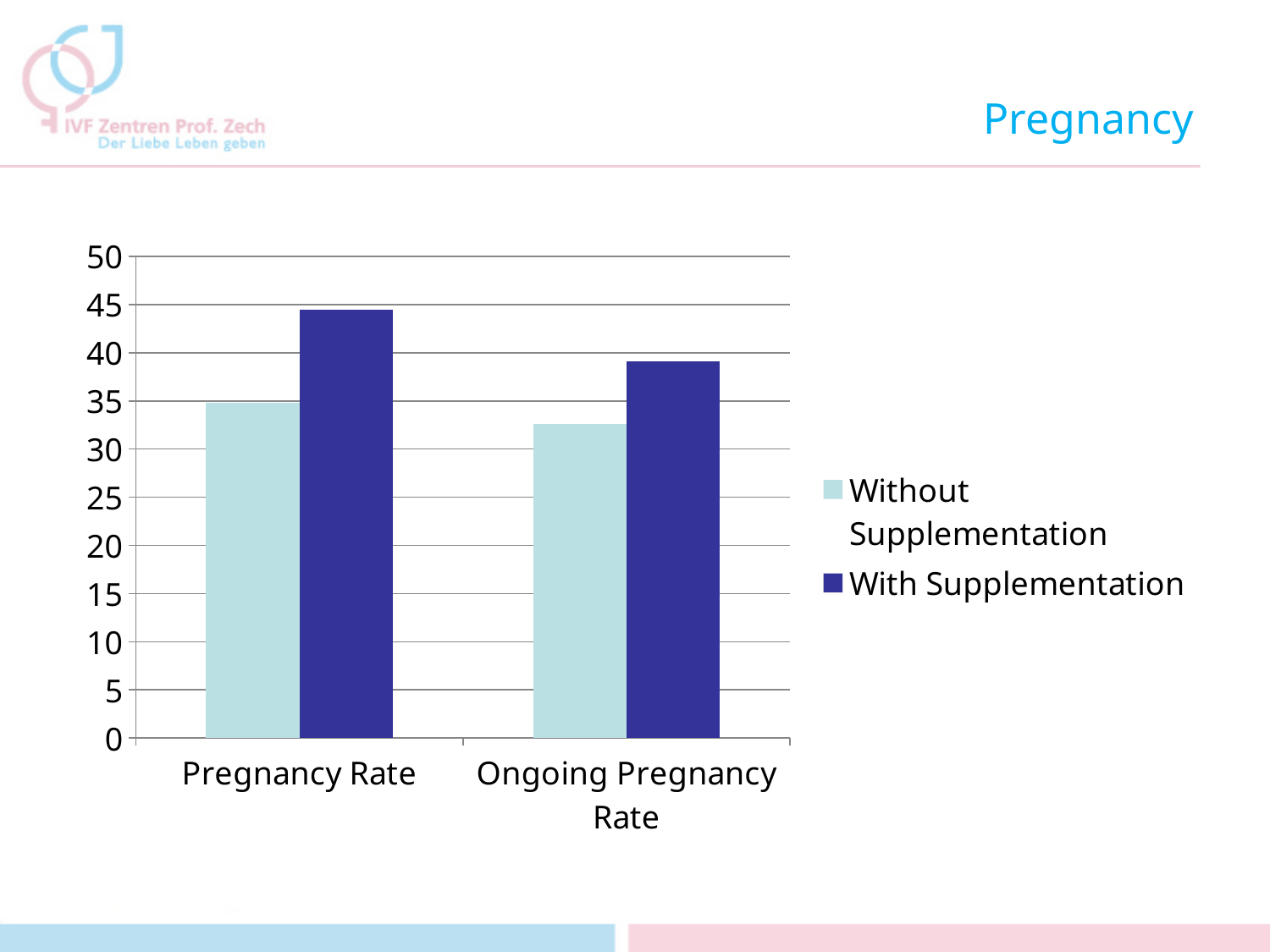
How many series does the legend list? 2 Which bar is the lowest in the chart? Without Supplementation, Ongoing Pregnancy Rate For Pregnancy Rate, which series has the larger value: Without Supplementation or With Supplementation? With Supplementation What is the title of the slide? Pregnancy How many categories are shown on the x axis? 2 Which bar is the highest in the chart? With Supplementation, Pregnancy Rate Is the Ongoing Pregnancy Rate value for Without Supplementation greater or less than 30? greater Which series is shown in dark blue? With Supplementation Is the Pregnancy Rate value for With Supplementation greater or less than 40? greater What kind of chart is shown on the slide? bar chart Is the Pregnancy Rate value for Without Supplementation greater or less than 40? less